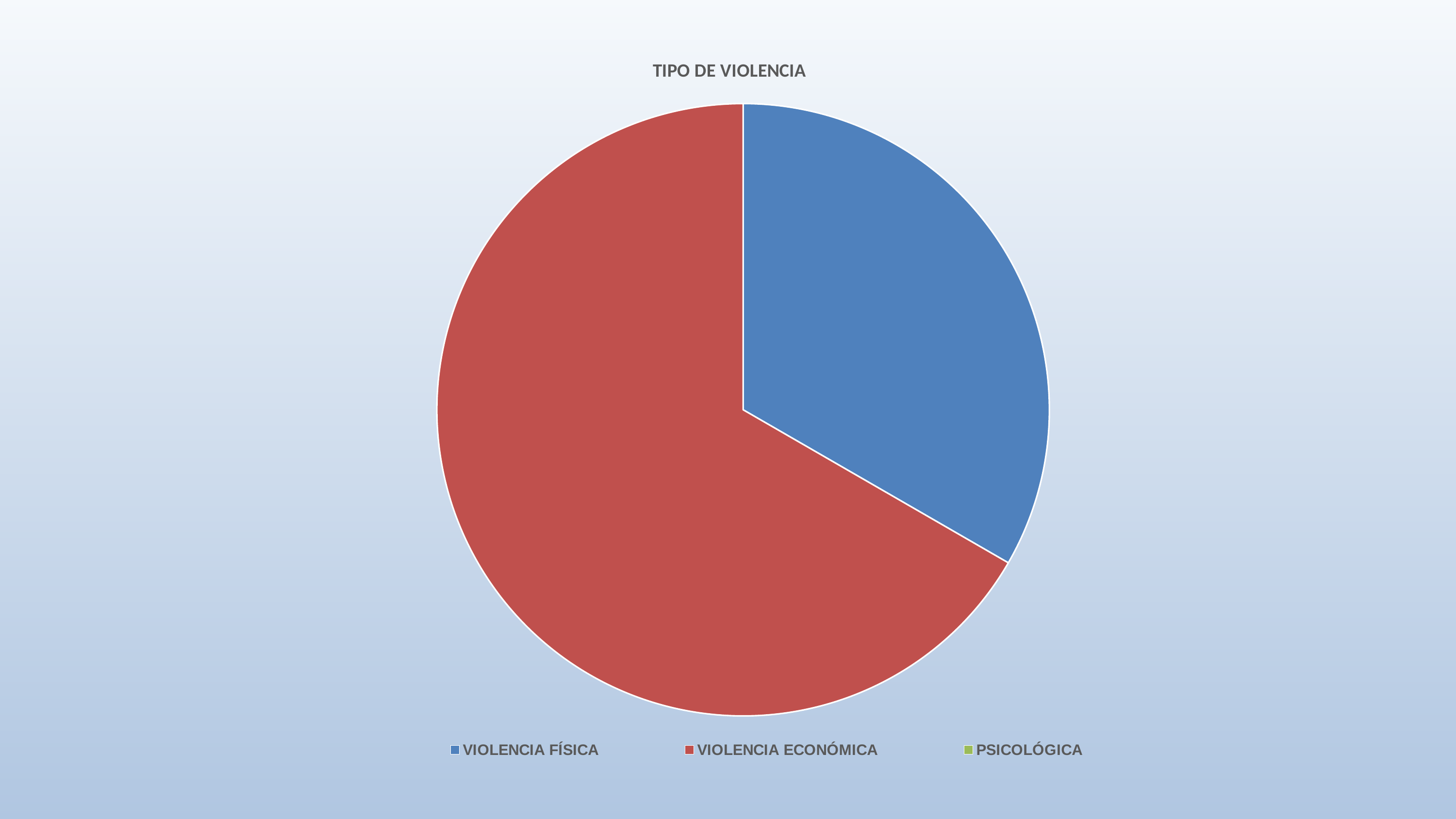
How many slices are visibly drawn in the pie? 2 What is the title of the chart? TIPO DE VIOLENCIA Which category has the largest slice of the pie? VIOLENCIA ECONÓMICA Which is larger, the slice for VIOLENCIA FÍSICA or the slice for PSICOLÓGICA? VIOLENCIA FÍSICA Which is larger, the slice for VIOLENCIA FÍSICA or the slice for VIOLENCIA ECONÓMICA? VIOLENCIA ECONÓMICA How many categories does the legend of the chart list? 3 What kind of chart is shown on the slide? pie chart What colour is the slice for VIOLENCIA ECONÓMICA? red